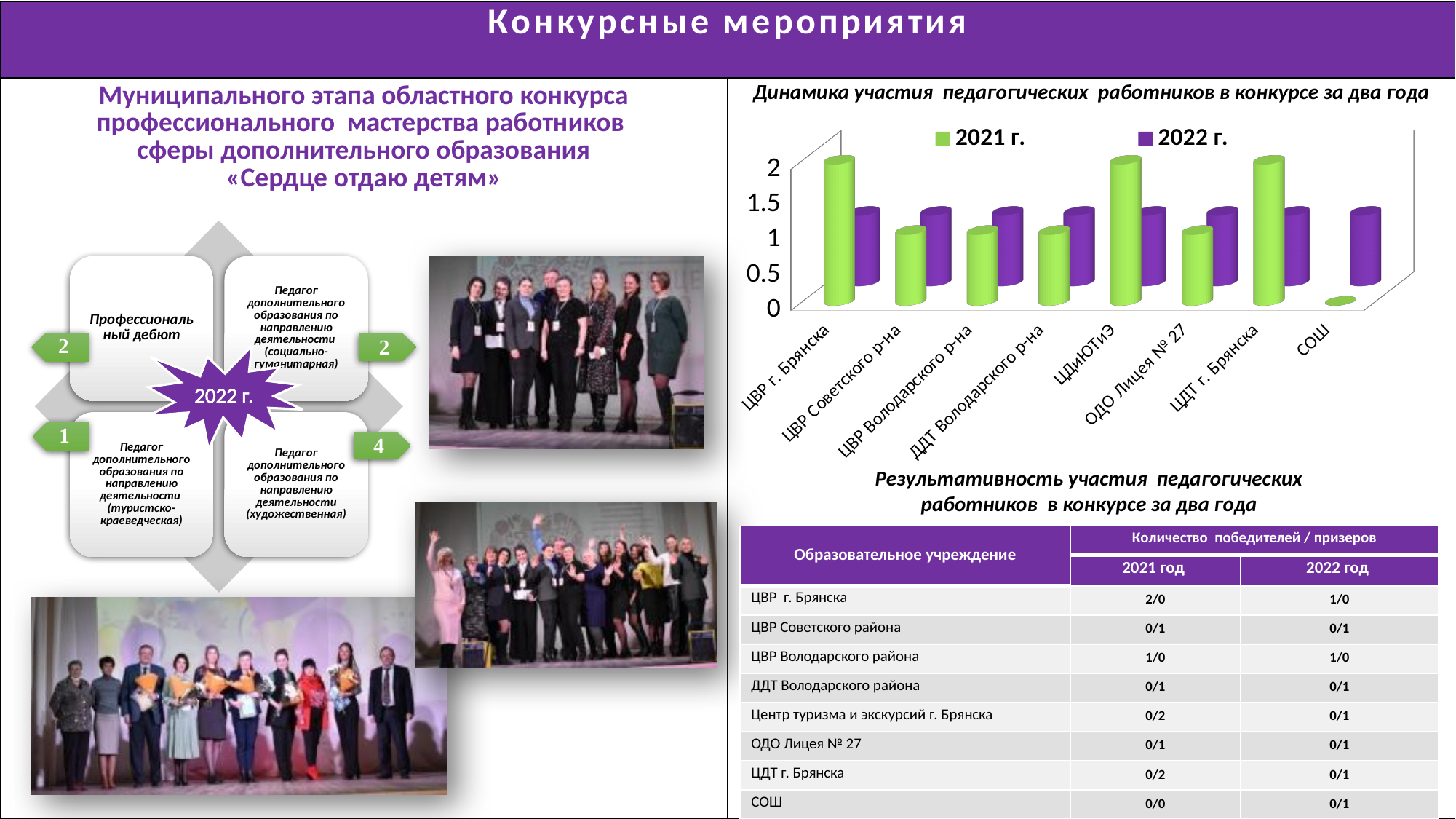
What is the 2021 г. value for СОШ? 0 Which category has the lowest 2021 г. value? СОШ Is the 2022 г. value for СОШ greater or less than 0.5? greater How many categories are shown along the x axis of the chart? 8 How many series does the legend of the chart list? 2 What is the difference between the 2021 г. values for ЦВР г. Брянска and ЦВР Володарского р-на? 1 Which has the larger 2021 г. value: ЦДиЮТиЭ or ОДО Лицея № 27? ЦДиЮТиЭ What is the 2021 г. value for ЦВР г. Брянска? 2 What kind of chart is shown on the slide? bar chart What is the 2021 г. value for ЦВР Советского р-на? 1 What colour represents the 2021 г. series in the chart? green What is the title of the chart? Динамика участия педагогических работников в конкурсе за два года